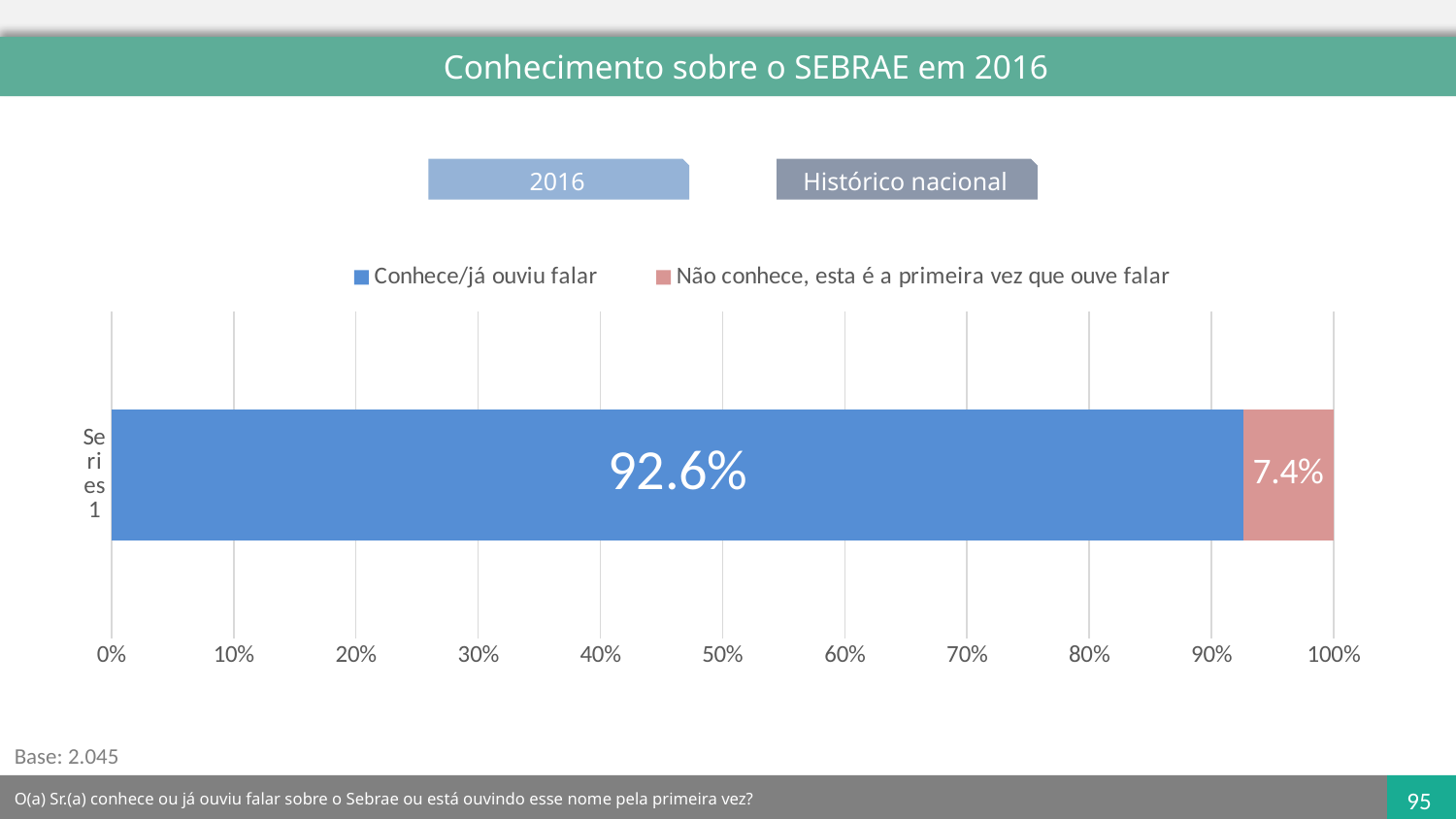
What kind of chart is shown on the slide? Bar chart What is the difference between the values for "Conhece/já ouviu falar" and "Não conhece, esta é a primeira vez que ouve falar"? 85.2% What colour is the bar segment for "Não conhece, esta é a primeira vez que ouve falar"? Pink/red What is the highest value shown on the x axis? 100% What is the value for "Não conhece, esta é a primeira vez que ouve falar"? 7.4% What is the total of the stacked bar? 100% What is the value for "Conhece/já ouviu falar"? 92.6% Which series has the larger value, "Conhece/já ouviu falar" or "Não conhece, esta é a primeira vez que ouve falar"? Conhece/já ouviu falar What is the title of the slide containing the chart? Conhecimento sobre o SEBRAE em 2016 Is the value for "Não conhece, esta é a primeira vez que ouve falar" greater or less than 10%? less How many series does the legend list? 2 Is the value for "Conhece/já ouviu falar" greater or less than 90%? greater